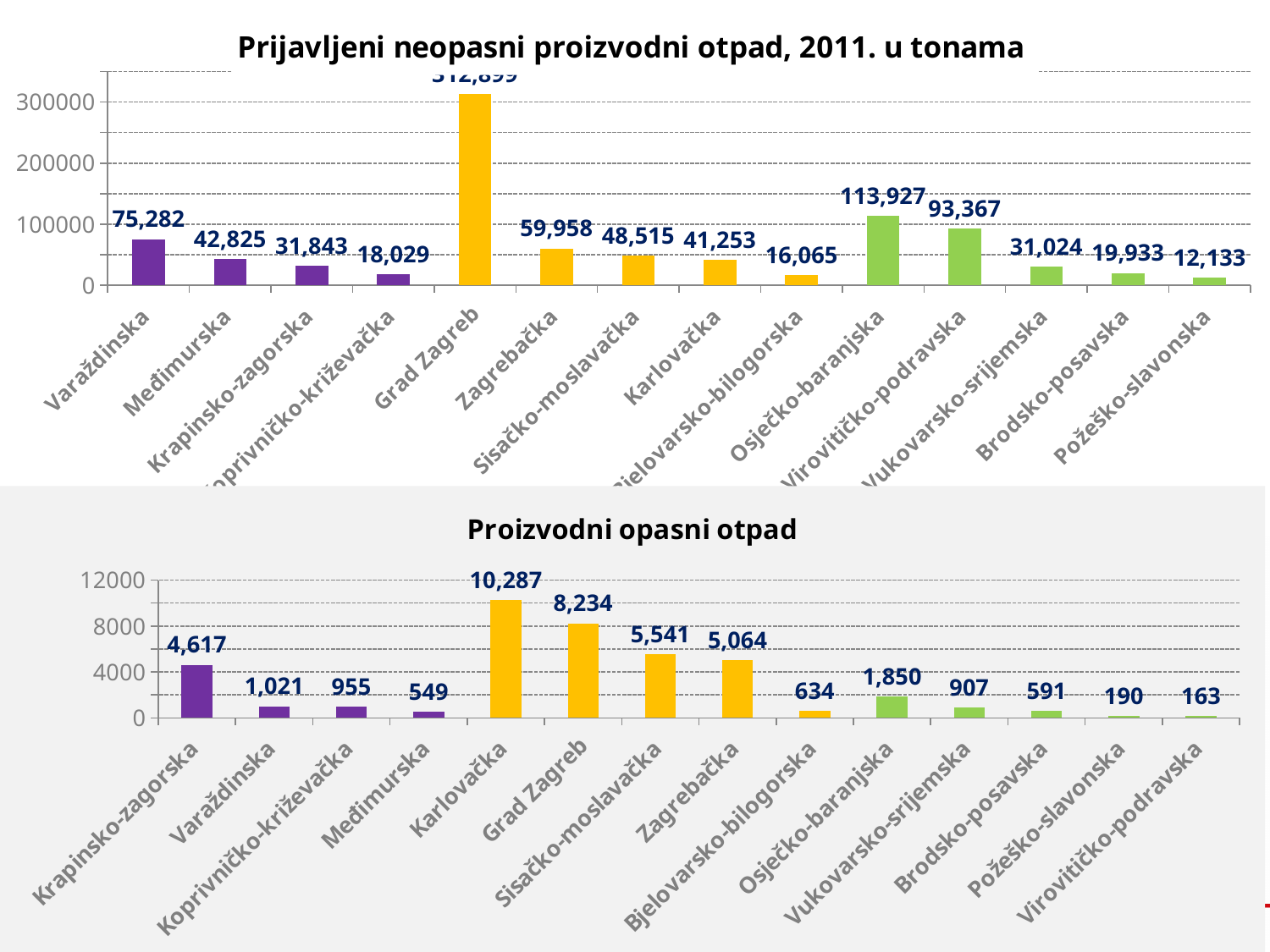
In the top chart 'Prijavljeni neopasni proizvodni otpad, 2011. u tonama', how many categories are shown? 14 In the top chart 'Prijavljeni neopasni proizvodni otpad, 2011. u tonama', which category has the highest value? Grad Zagreb In the top chart 'Prijavljeni neopasni proizvodni otpad, 2011. u tonama', what is the difference between Osječko-baranjska and Virovitičko-podravska? 20,560 In the bottom chart 'Proizvodni opasni otpad', which category has the lowest value? Virovitičko-podravska What type of chart is the bottom chart 'Proizvodni opasni otpad'? Bar chart In the top chart 'Prijavljeni neopasni proizvodni otpad, 2011. u tonama', what is the value for Osječko-baranjska? 113,927 In the top chart 'Prijavljeni neopasni proizvodni otpad, 2011. u tonama', which category has the lowest value? Požeško-slavonska In the top chart 'Prijavljeni neopasni proizvodni otpad, 2011. u tonama', which is larger: Zagrebačka or Sisačko-moslavačka? Zagrebačka In the bottom chart 'Proizvodni opasni otpad', is the value for Krapinsko-zagorska greater or less than 4000? greater In the top chart 'Prijavljeni neopasni proizvodni otpad, 2011. u tonama', what is the value for Varaždinska? 75,282 In the bottom chart 'Proizvodni opasni otpad', what is the difference between Grad Zagreb and Zagrebačka? 3,170 In the bottom chart 'Proizvodni opasni otpad', what is the value for Karlovačka? 10,287